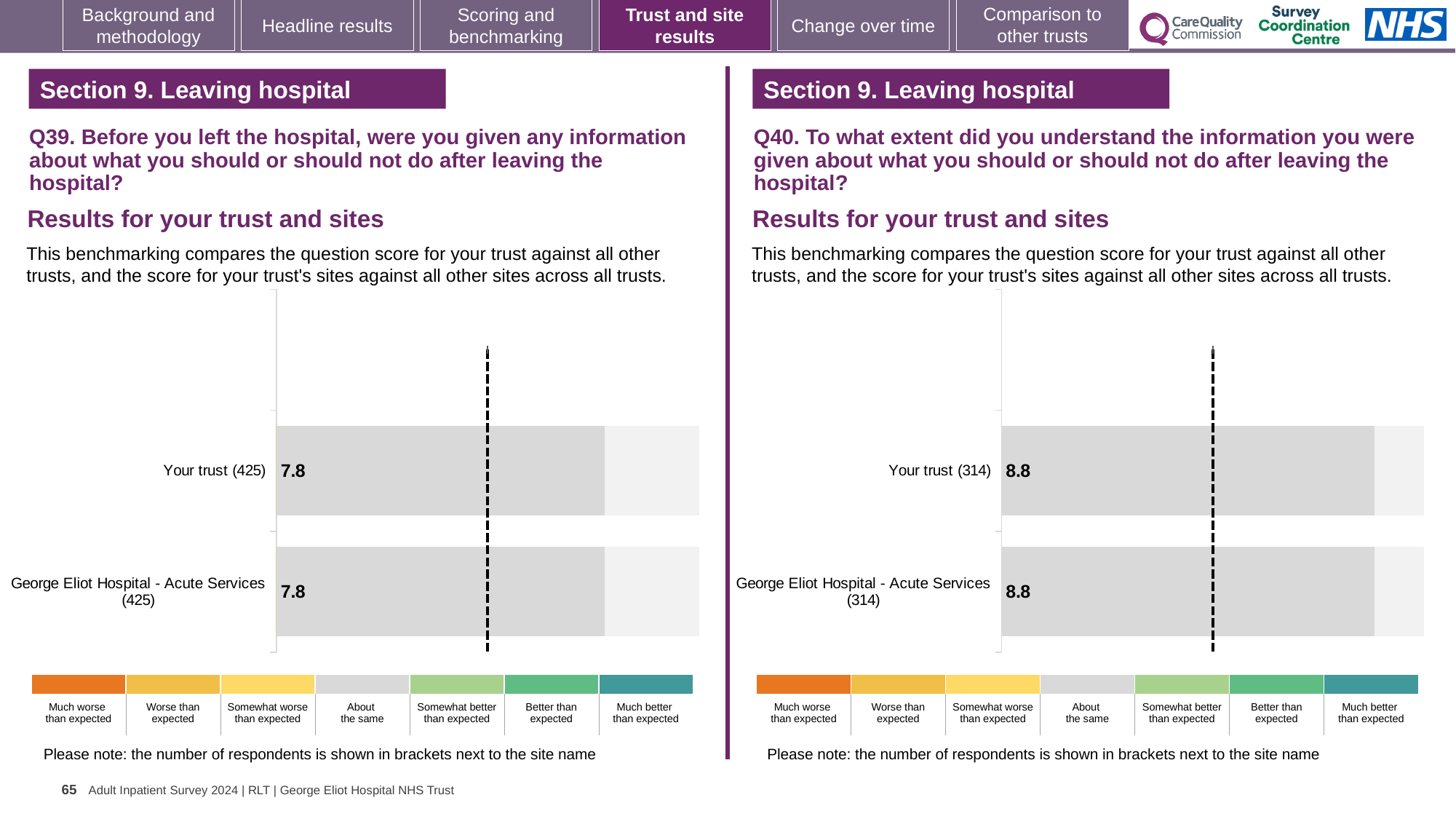
On the Q40 chart on the right, what is the difference between the score for Your trust and the score for George Eliot Hospital - Acute Services? 0 How many bars are plotted on the Q39 chart on the left? 2 What type of chart is used on the Q39 chart on the left? Bar chart How many bars are plotted on the Q40 chart on the right? 2 On the Q39 chart on the left, what is the score for George Eliot Hospital - Acute Services? 7.8 On the Q39 chart on the left, what is the score for Your trust? 7.8 On the Q40 chart on the right, how many respondents are shown in brackets for George Eliot Hospital - Acute Services? 314 On the Q39 chart on the left, what is the difference between the score for Your trust and the score for George Eliot Hospital - Acute Services? 0 On the Q39 chart on the left, how many respondents are shown in brackets for Your trust? 425 On the Q40 chart on the right, what is the score for Your trust? 8.8 Is the score for Your trust on the Q40 chart on the right larger or smaller than the score for Your trust on the Q39 chart on the left? Larger On the Q40 chart on the right, what is the score for George Eliot Hospital - Acute Services? 8.8